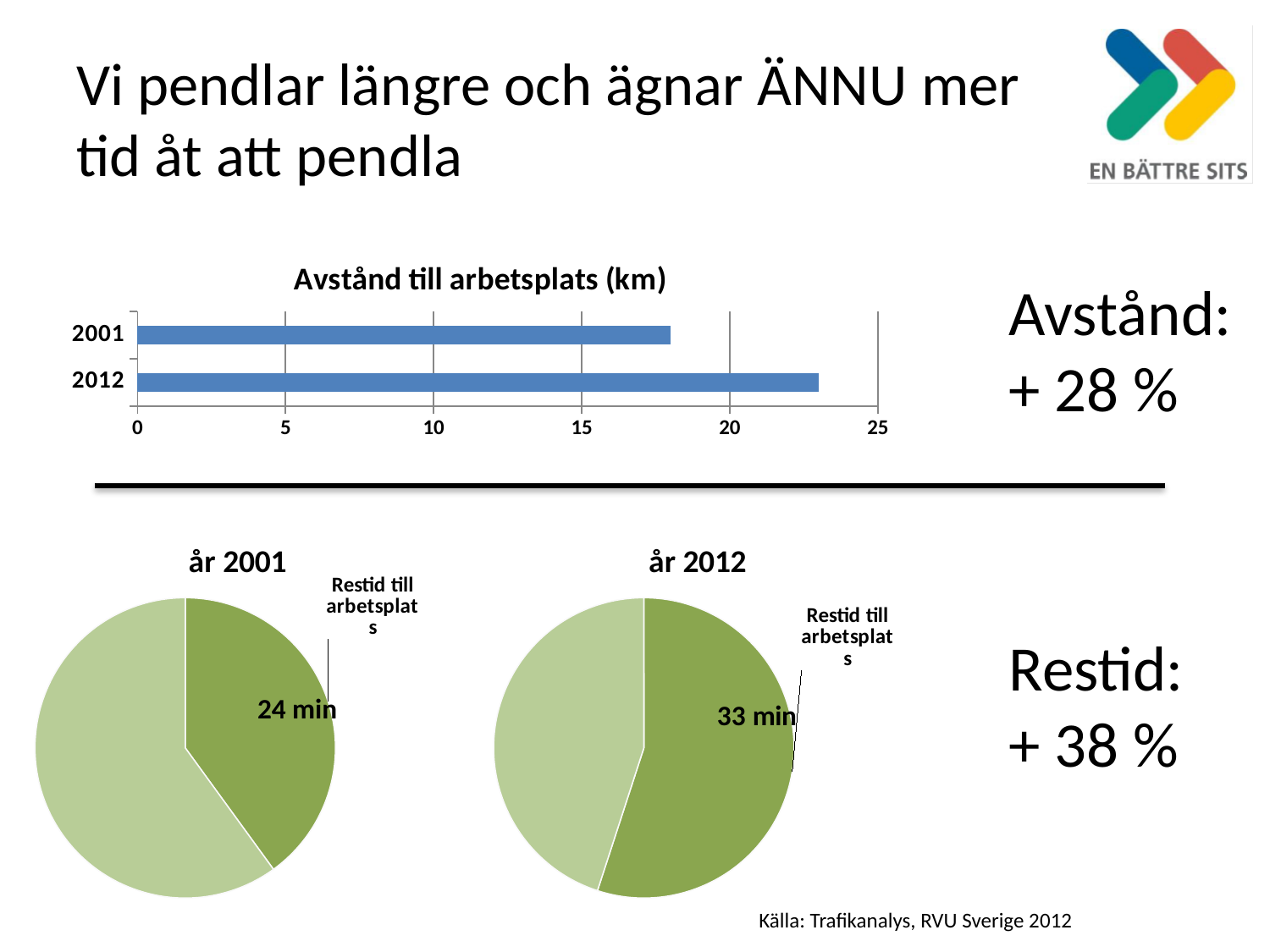
What type of chart is the chart titled 'Avstånd till arbetsplats (km)'? bar chart What is the difference between the 'Restid till arbetsplats' value in the 'år 2012' pie chart and the 'år 2001' pie chart? 9 min In the chart 'Avstånd till arbetsplats (km)', is the value for 2012 greater or less than 20? greater In the pie chart titled 'år 2012', what value is labelled for 'Restid till arbetsplats'? 33 min In the chart 'Avstånd till arbetsplats (km)', which year has the longer bar? 2012 In the chart 'Avstånd till arbetsplats (km)', is the value for 2001 greater or less than 15? greater How many categories are shown in the chart 'Avstånd till arbetsplats (km)'? 2 In the chart 'Avstånd till arbetsplats (km)', what is the highest value shown on the x axis? 25 In the pie chart titled 'år 2001', what value is labelled for 'Restid till arbetsplats'? 24 min In the chart 'Avstånd till arbetsplats (km)', is the value for 2001 greater or less than 20? less In the chart 'Avstånd till arbetsplats (km)', which year has the shorter bar? 2001 Comparing the pie charts 'år 2001' and 'år 2012', which year shows the larger value for 'Restid till arbetsplats'? år 2012